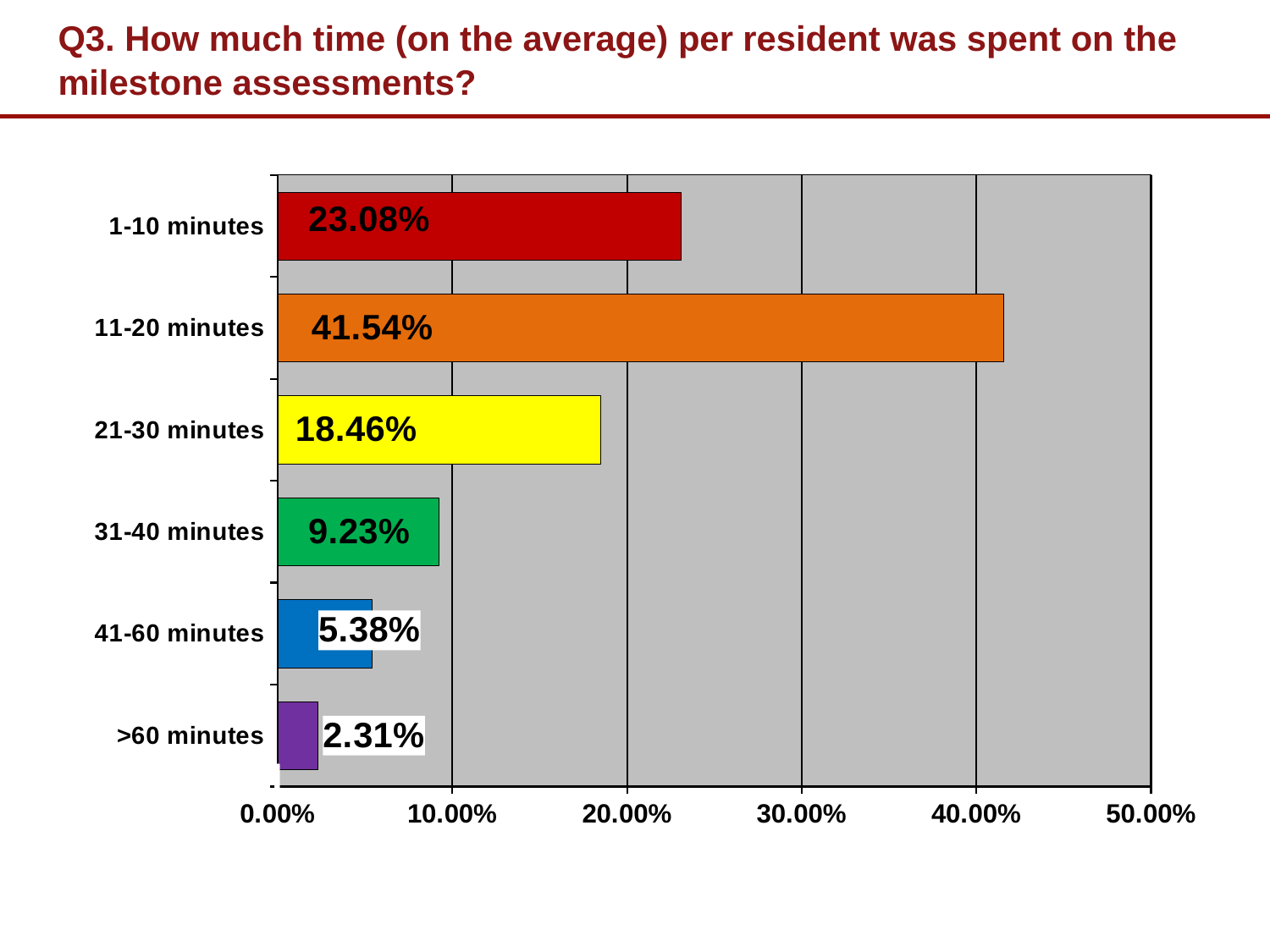
Which is larger, the percentage for 21-30 minutes or for 31-40 minutes? 21-30 minutes What is the difference between the percentages for 21-30 minutes and 31-40 minutes? 9.23% What percentage of respondents spent 11-20 minutes per resident on the milestone assessments? 41.54% What colour is the bar for the 31-40 minutes category? Green How many time categories are shown on the chart? 6 What is the value shown for the >60 minutes category? 2.31% What kind of chart is shown on the slide? Bar chart Which time category has the lowest percentage? >60 minutes Which time category has the highest percentage? 11-20 minutes What is the value shown for the 1-10 minutes category? 23.08% What is the difference between the percentages for 11-20 minutes and 1-10 minutes? 18.46% Is the value for 41-60 minutes greater or less than 10.00%? less